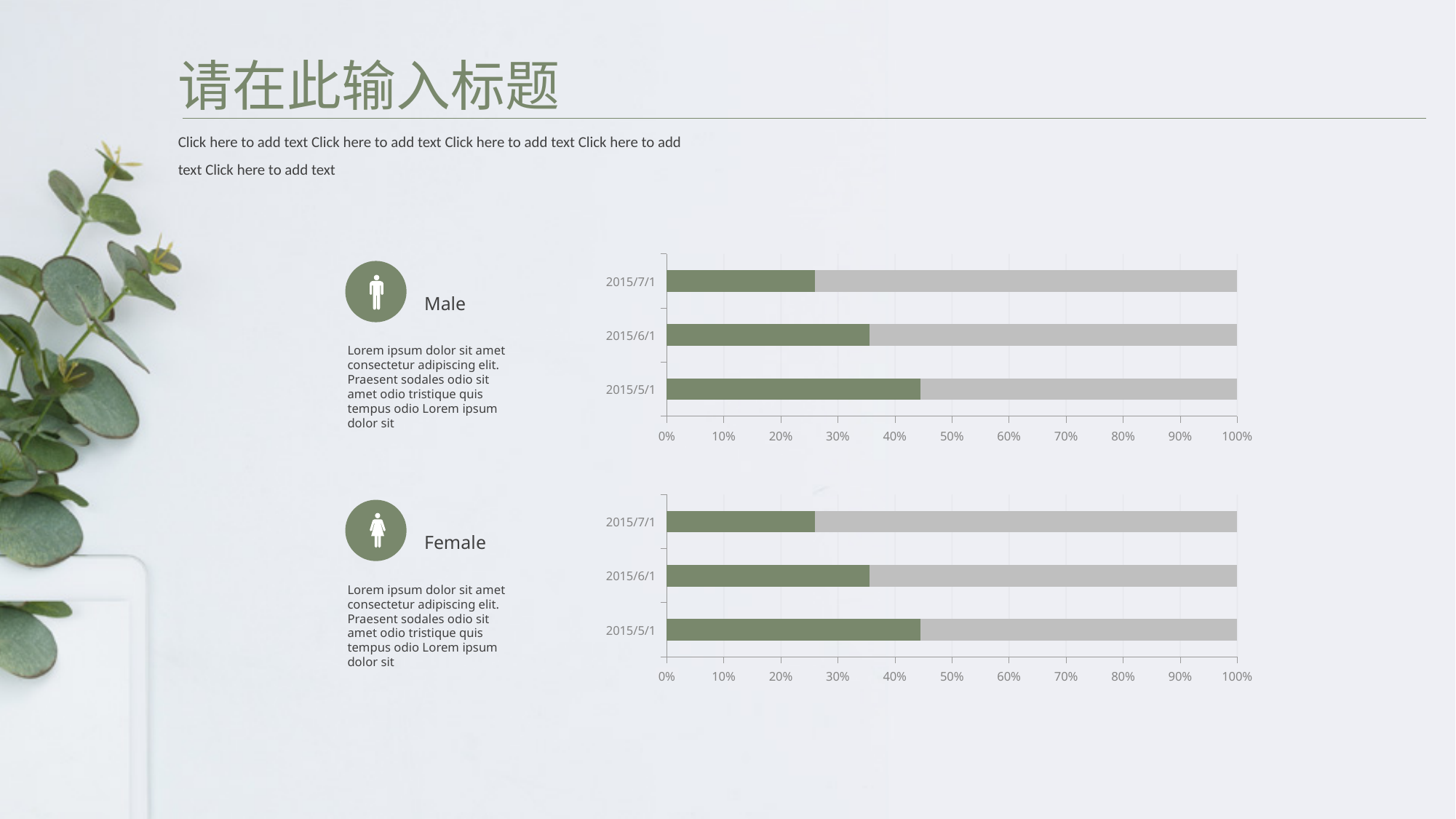
In the Male chart at the top, which has the larger green segment, 2015/6/1 or 2015/7/1? 2015/6/1 In the Female chart at the bottom, which date has the shortest green segment? 2015/7/1 In the Female chart at the bottom, is the green segment for 2015/6/1 greater or less than 30%? greater In the Male chart at the top, is the green segment for 2015/5/1 greater or less than 40%? greater In the Male chart at the top, which date has the longest green segment? 2015/5/1 In the Male chart at the top, is the green segment for 2015/7/1 greater or less than 30%? less In the Male chart at the top, what colour is the segment that extends to 100% for each date? gray In the Female chart at the bottom, what is the highest value shown on the x axis? 100% In the Female chart at the bottom, how many date categories are plotted? 3 In the Male chart at the top, what kind of chart is shown? bar chart In the Male chart at the top, how many date categories are plotted? 3